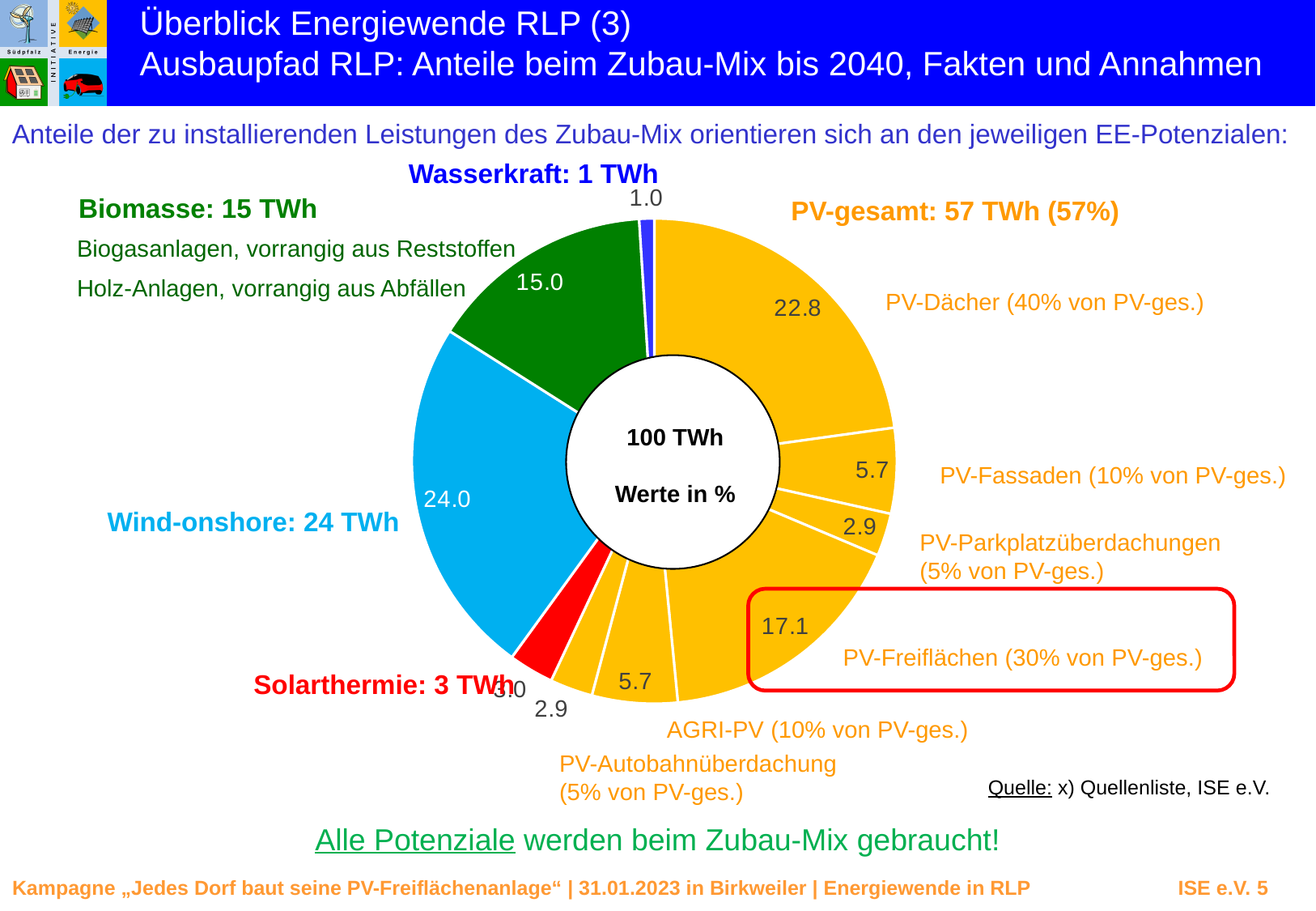
What value is shown for the Wasserkraft slice? 1.0 What text is printed in the centre of the doughnut chart? 100 TWh, Werte in % Which slice of the chart has the smallest value? Wasserkraft What value is shown for the Biomasse slice? 15.0 What value is shown for the Wind-onshore slice of the doughnut chart? 24.0 How many slices does the doughnut chart have? 10 What is the difference between the Wind-onshore value and the PV-Dächer value? 1.2 Which is larger, the PV-Freiflächen slice or the Biomasse slice? PV-Freiflächen What value is shown for the PV-Freiflächen slice? 17.1 What value is shown for the PV-Dächer slice? 22.8 What kind of chart is shown on the slide? Doughnut (pie) chart Which slice of the chart has the largest value? Wind-onshore